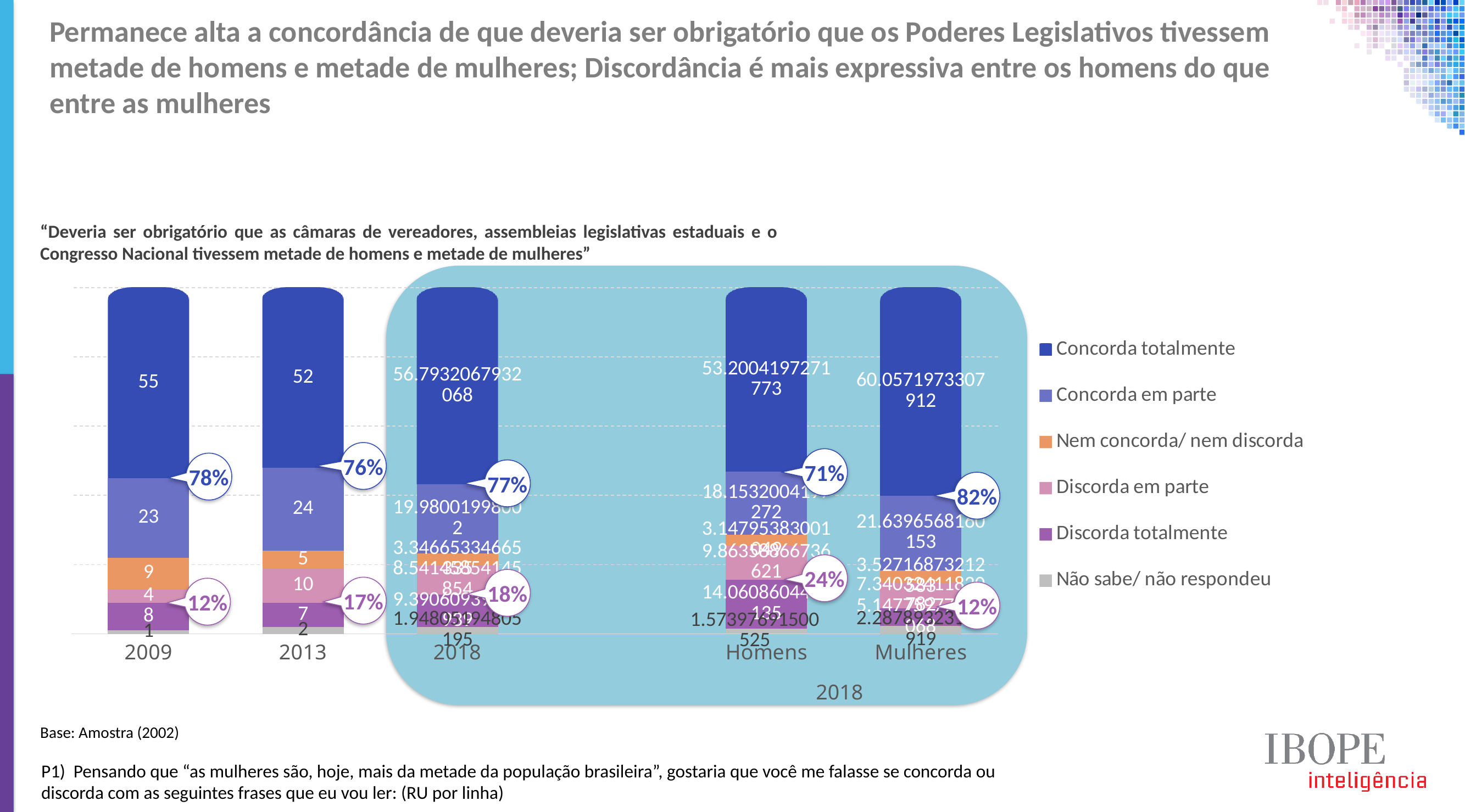
What is the value for "Concorda em parte" in 2013? 24 How many series does the legend list? 6 What is the difference between the "Concorda totalmente" values for 2009 and 2013? 3 How many bars (categories) are shown on the x axis? 5 What disagreement percentage is shown in the callout for "Homens"? 24% What is the total of the stacked bar for 2009? 100 Which year has the larger value for "Nem concorda/ nem discorda", 2009 or 2013? 2009 What is the value for "Concorda totalmente" in 2009? 55 What is the value for "Discorda totalmente" in 2009? 8 What kind of chart is shown on the slide? Stacked bar chart What agreement percentage is shown in the callout for "Mulheres"? 82% What is the value for "Discorda em parte" in 2013? 10